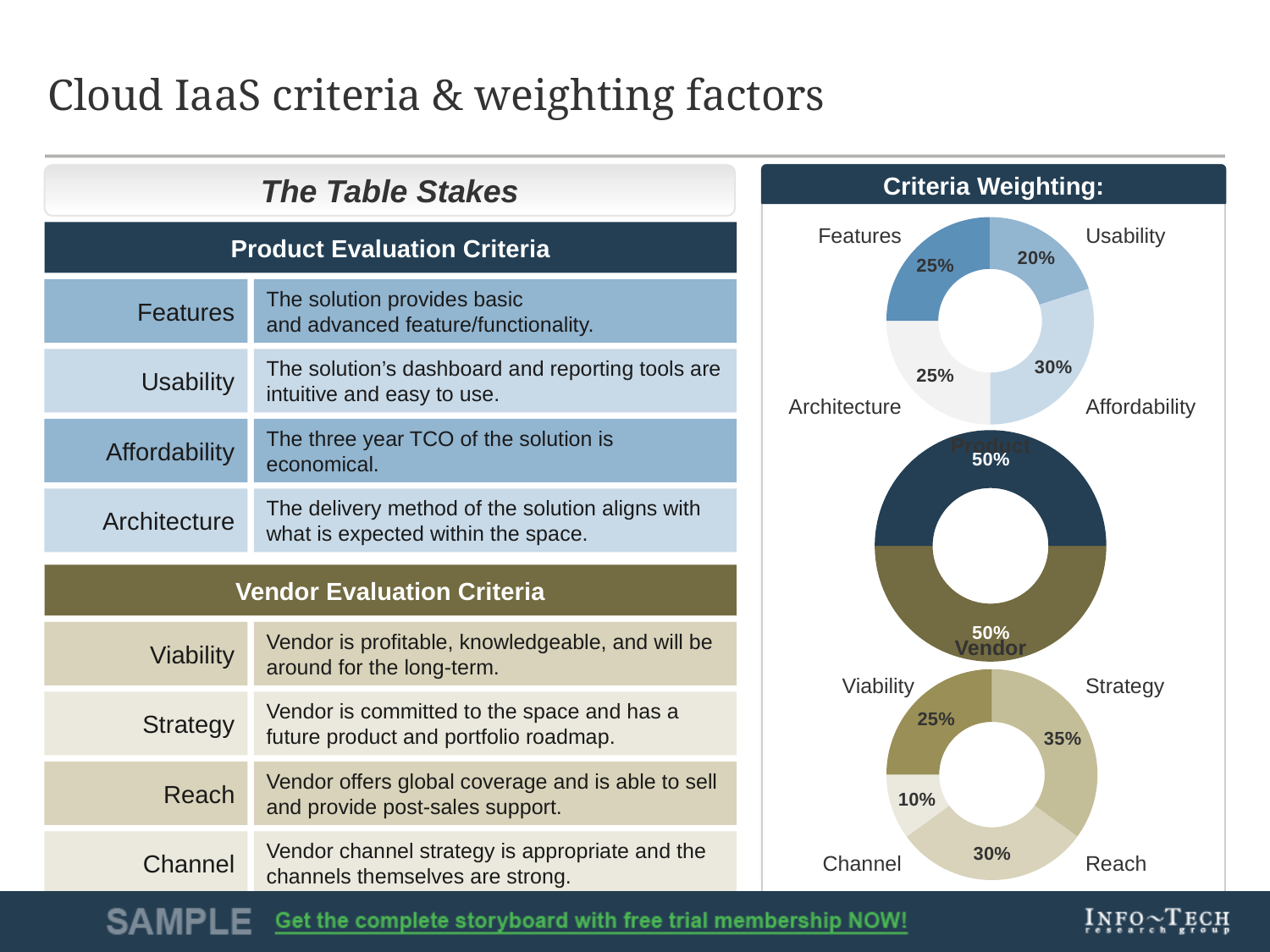
In the top donut chart (product criteria), what is the weighting for Affordability? 30% In the middle donut chart, how many segments are there? 2 In the bottom donut chart (vendor criteria), what is the weighting for Strategy? 35% In the bottom donut chart (vendor criteria), which has a larger weighting, Viability or Reach? Reach In the middle donut chart, what is the weighting for Vendor? 50% In the bottom donut chart (vendor criteria), what is the difference between the weightings for Strategy and Channel? 25% What type of chart is used to show the criteria weighting on the right side of the slide? Donut (pie) chart In the top donut chart (product criteria), which criterion has the lowest weighting? Usability In the top donut chart (product criteria), what is the weighting for Usability? 20% In the bottom donut chart (vendor criteria), which criterion has the lowest weighting? Channel In the top donut chart (product criteria), how many criteria are shown? 4 In the top donut chart (product criteria), which criterion has the highest weighting? Affordability